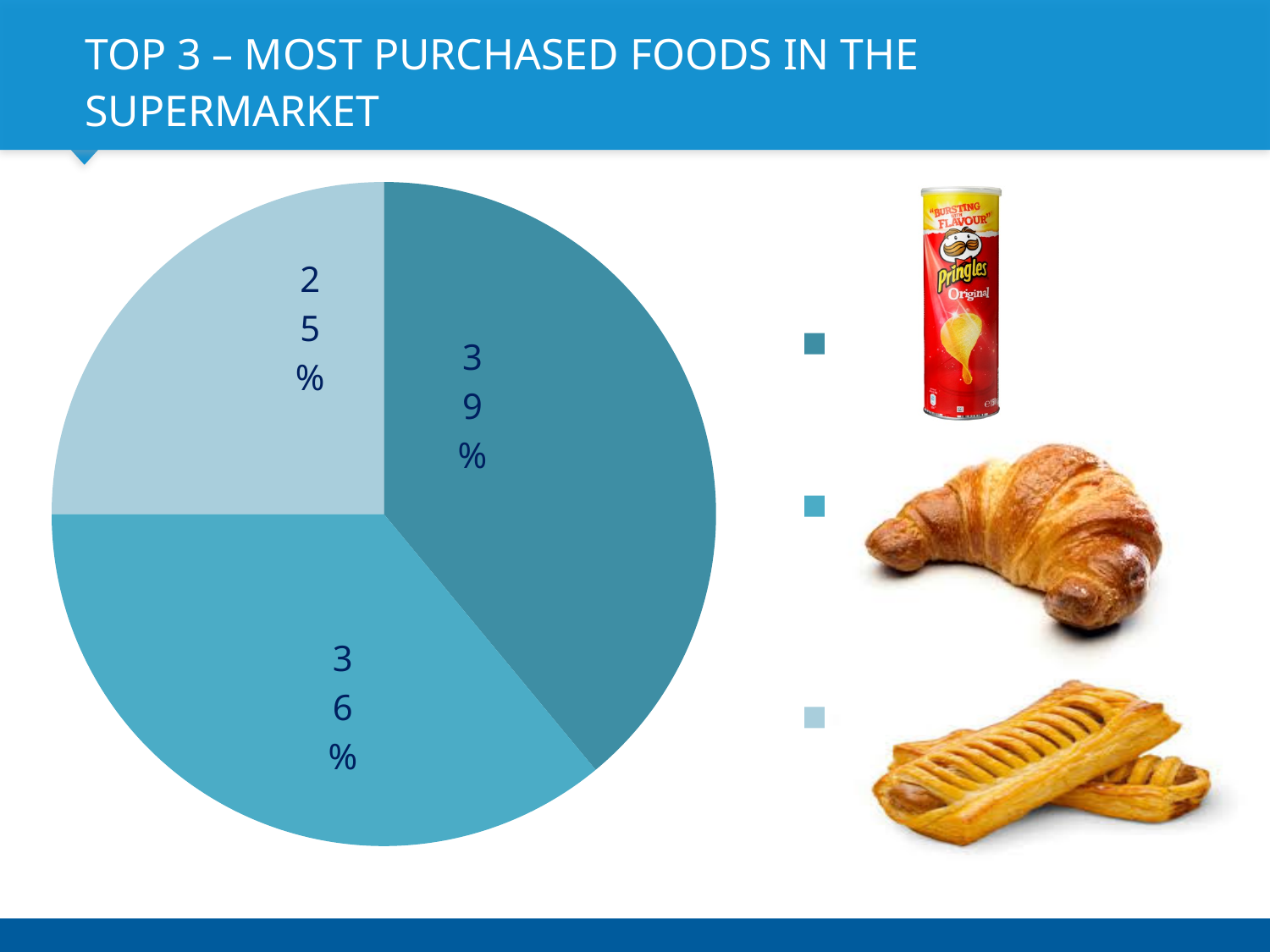
What is the difference between the 39% slice and the 25% slice? 14 percentage points What do the three slice percentages in the pie chart add up to? 100% What is the title of the slide containing the pie chart? TOP 3 – MOST PURCHASED FOODS IN THE SUPERMARKET What kind of chart is shown on the slide? pie chart What is the largest share shown in the pie chart? 39% What is the difference between the largest slice (39%) and the second-largest slice (36%)? 3 percentage points What is the difference between the 36% slice and the 25% slice? 11 percentage points What share of the pie does the dark teal slice, matching the Pringles legend entry, represent? 39% What is the smallest share shown in the pie chart? 25% How many slices does the pie chart have? 3 Which is larger, the medium-blue slice at the bottom or the light-blue slice at the top left? the medium-blue slice (36%) How many legend entries are shown next to the pie chart? 3